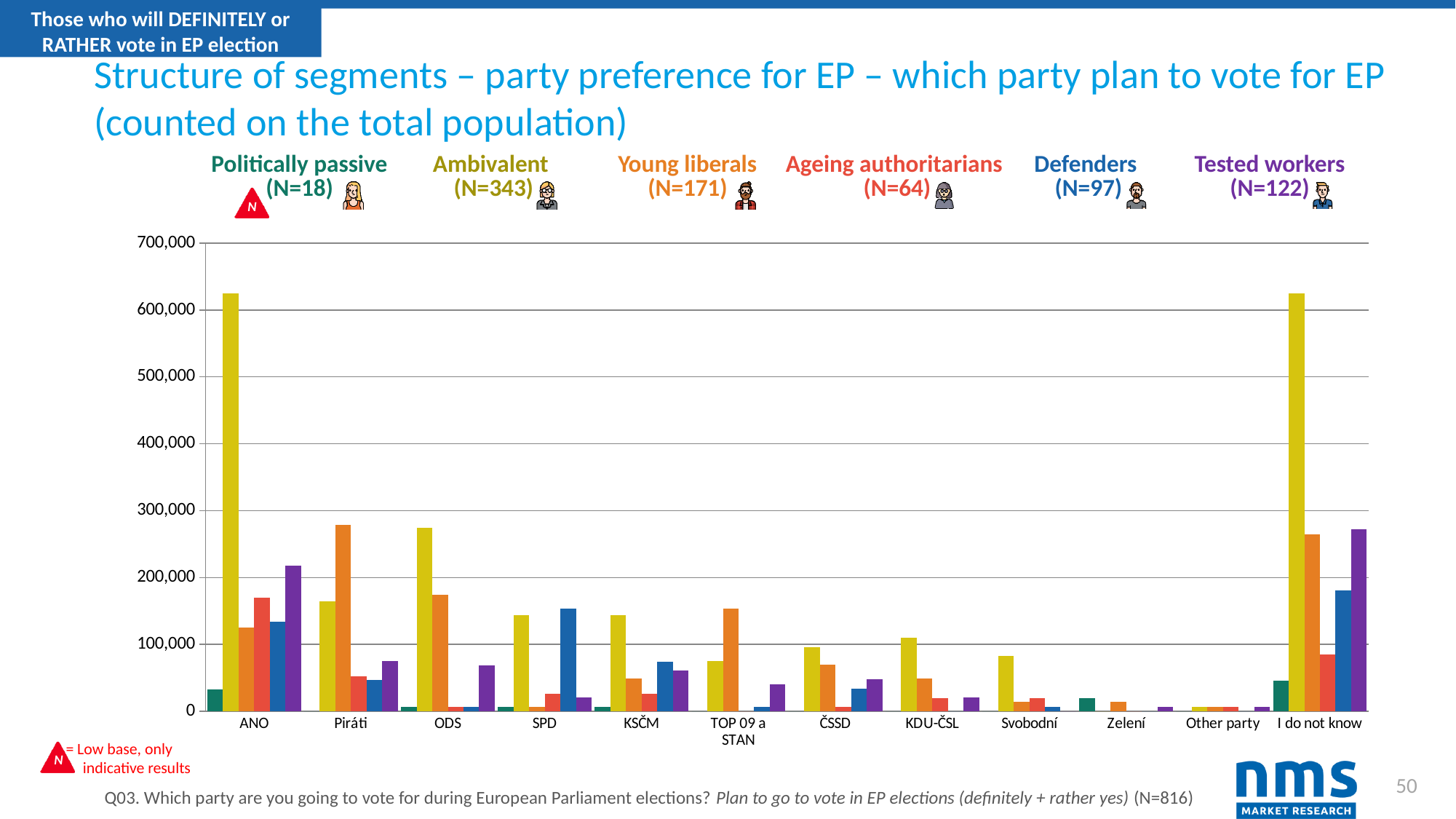
Is the Ambivalent value for ANO greater or less than 600,000? greater Which segment has the highest bar for 'I do not know'? Ambivalent How many segments (series) are listed in the legend above the chart? 6 Which segment has the highest bar for ANO? Ambivalent Is the Defenders value for SPD greater or less than 100,000? greater For ODS, which is larger: the Ambivalent value or the Young liberals value? Ambivalent How many party categories are shown on the x axis of the chart? 12 Which segment has the highest bar for SPD? Defenders Is the Young liberals value for Piráti greater or less than 200,000? greater What kind of chart is shown on the slide? bar chart What is the sample size (N) shown for the Ambivalent segment in the legend? N=343